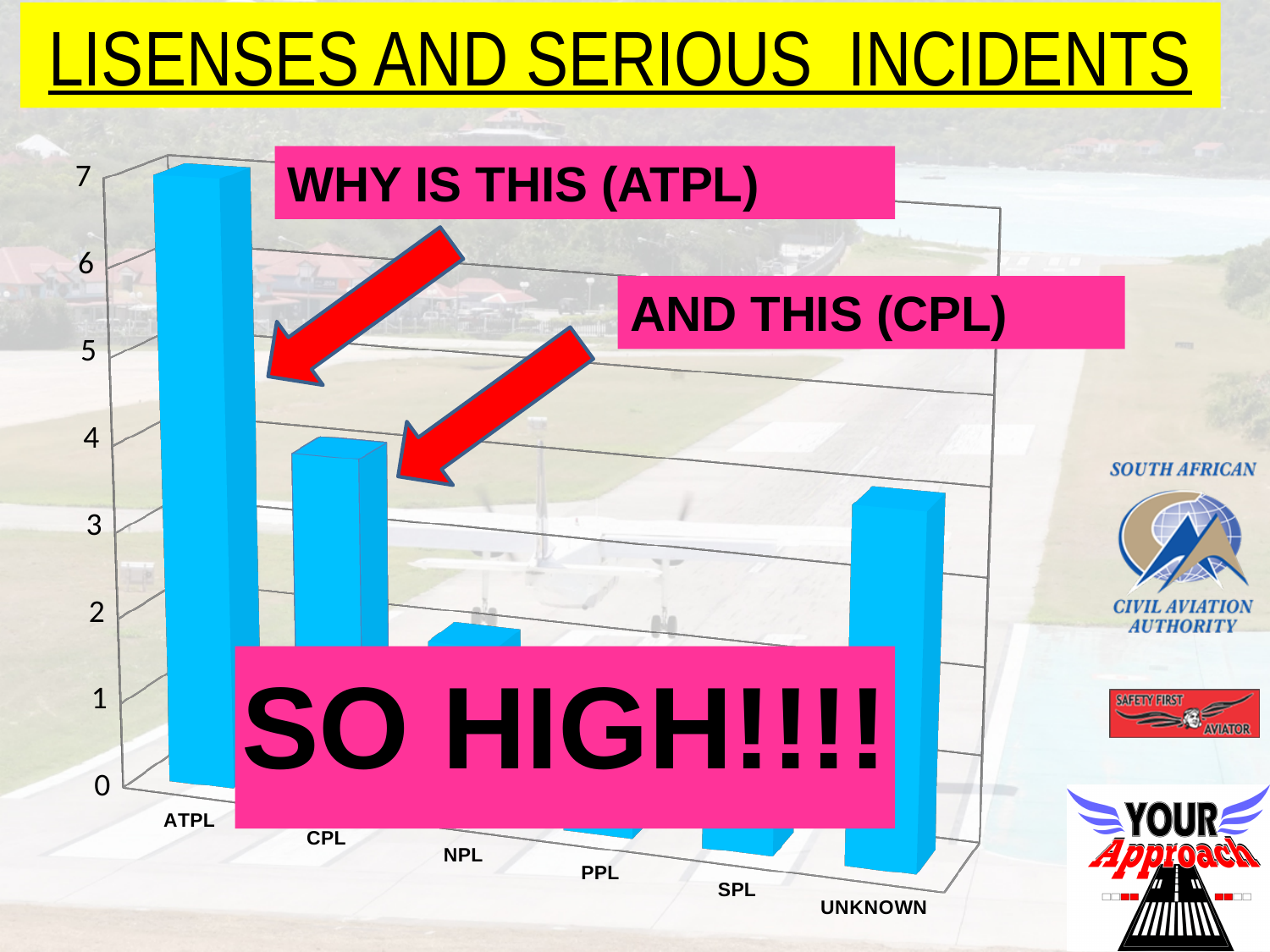
Is the value for CPL greater or less than 5? less How many licence categories are shown on the x axis of the chart? 6 Is the value for CPL greater or less than 3? greater Is the value for UNKNOWN greater or less than 2? greater What kind of chart is shown on the slide? bar chart Which is larger, the value for ATPL or the value for CPL? ATPL Which is larger, the value for UNKNOWN or the value for NPL? UNKNOWN What colour are the bars in the chart? blue Which licence category has the highest bar in the chart? ATPL What is the title shown at the top of the slide? LISENSES AND SERIOUS INCIDENTS